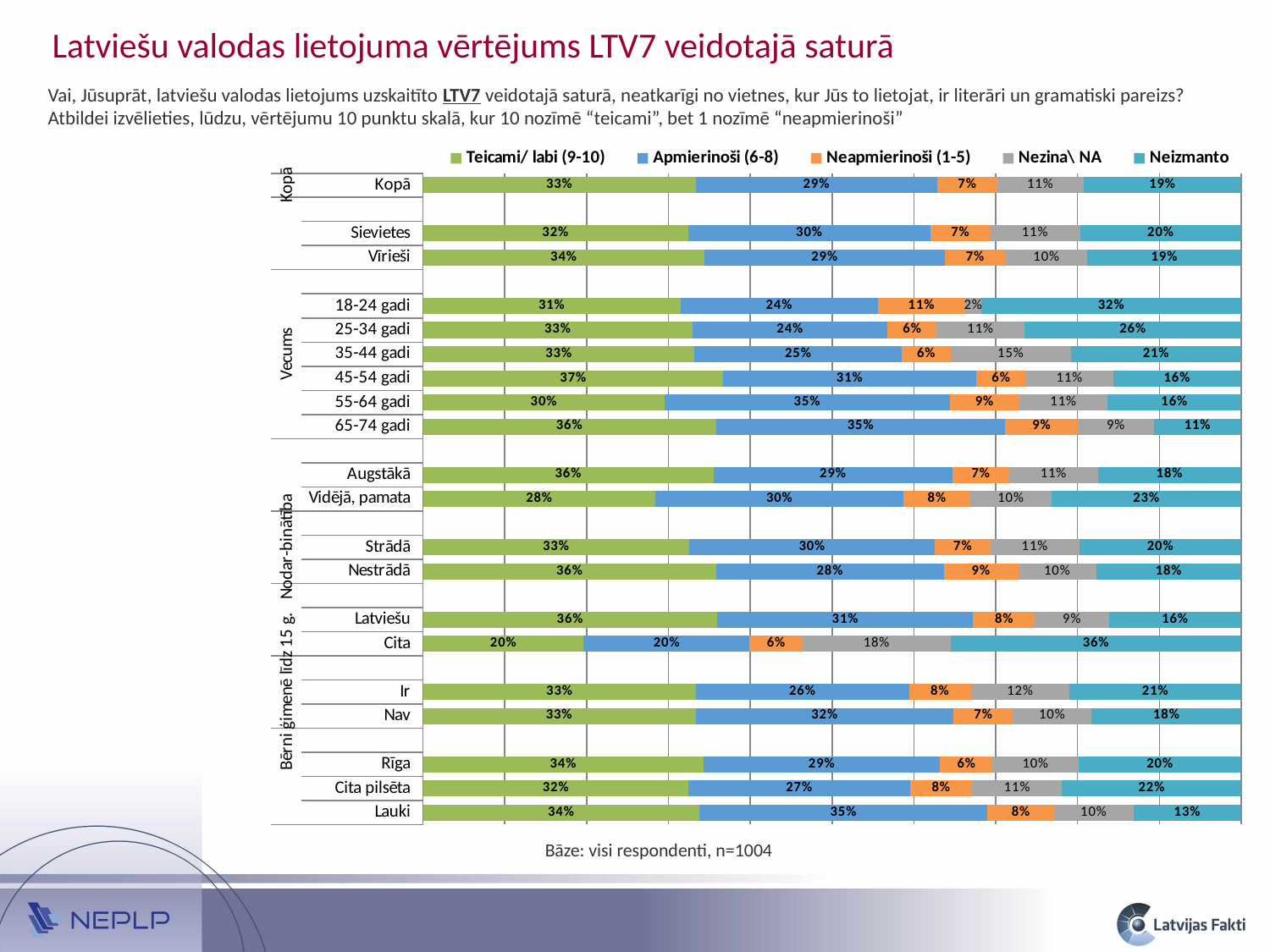
What kind of chart is shown on the slide? Stacked bar chart What is the Apmierinoši (6-8) value for Lauki? 35% Which category has the lowest Teicami/ labi (9-10) value? Cita What is the Nezina\ NA value for the Cita group? 18% Which category has the highest Teicami/ labi (9-10) value? 45-54 gadi Which has a larger Apmierinoši (6-8) value, Nav or Ir? Nav How many categories (rows) are plotted in the chart? 20 How many series does the legend list? 5 What percentage of respondents in the Kopā row rated the language use as Teicami/ labi (9-10)? 33% What is the difference between the Neizmanto values for Cita and Latviešu? 20% What is the total of the Kopā bar across all five segments? 99% What is the Neizmanto value for the 18-24 gadi group? 32%